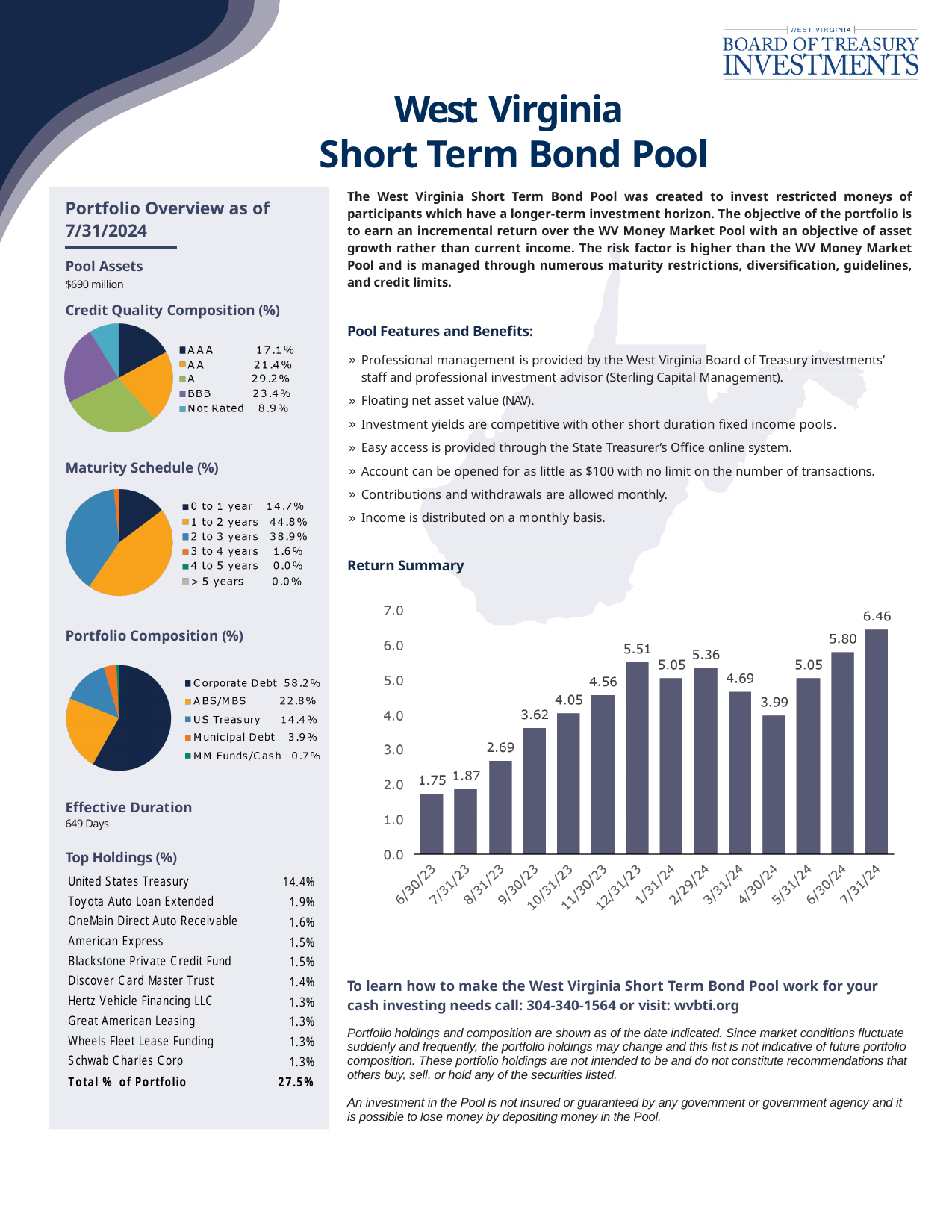
In the Return Summary chart, do the values generally rise or fall from 6/30/23 to 12/31/23? Rise In the Return Summary chart, what is the value for 7/31/24? 6.46 In the Credit Quality Composition pie chart, what share does A represent? 29.2% In the Maturity Schedule pie chart, what is the value for 1 to 2 years? 44.8% In the Return Summary chart, which date has the lowest value? 6/30/23 How many bars are plotted in the Return Summary chart? 14 What kind of chart is the Return Summary chart? Bar chart In the Return Summary chart, which is larger, the value for 12/31/23 or the value for 2/29/24? 12/31/23 In the Credit Quality Composition pie chart, which category has the largest share? A In the Portfolio Composition pie chart, what is the difference between Corporate Debt and ABS/MBS? 35.4% In the Return Summary chart, which date has the highest value? 7/31/24 In the Return Summary chart, what is the difference between the values for 6/30/24 and 4/30/24? 1.81